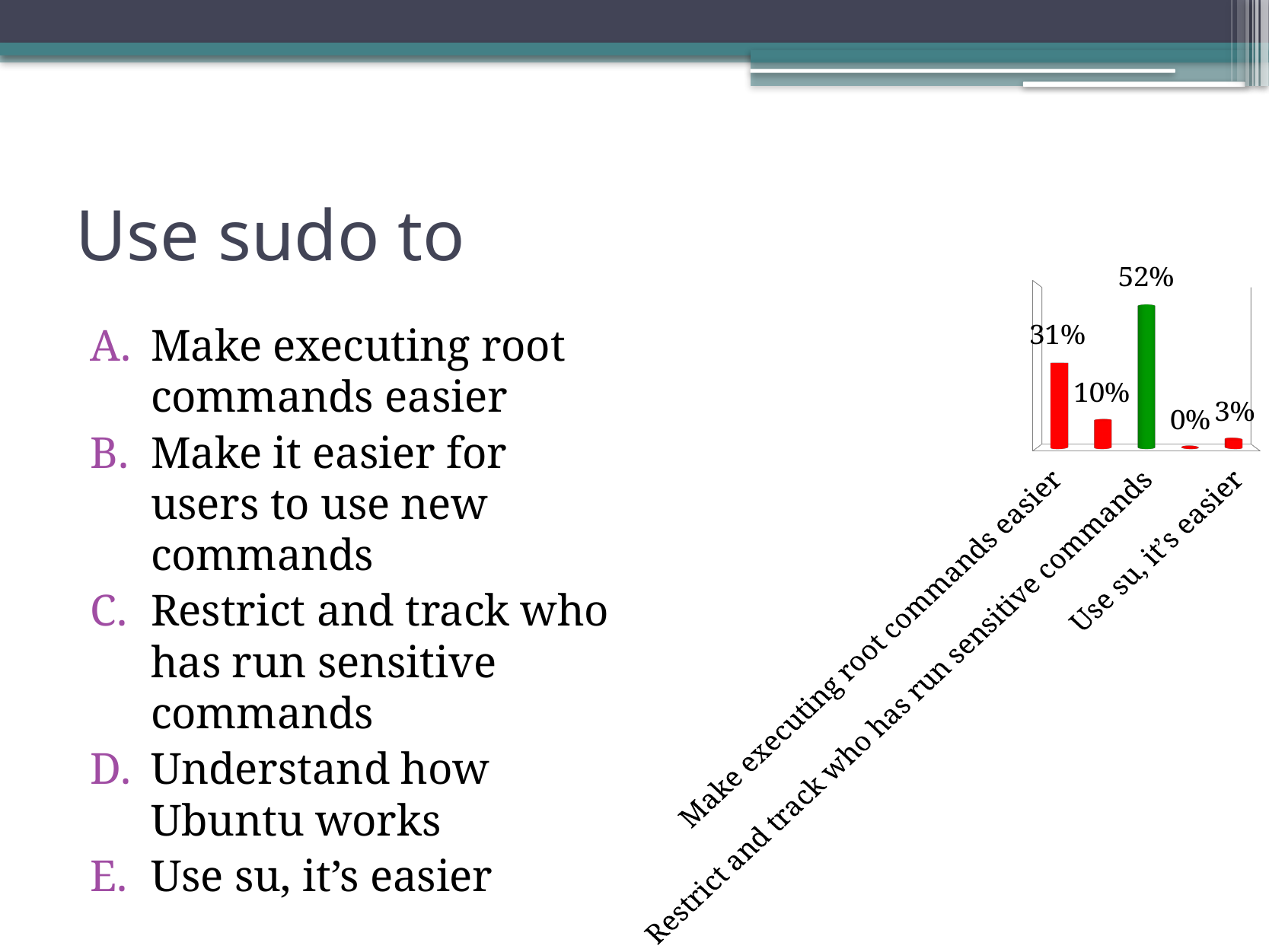
What is the difference between the values for "Restrict and track who has run sensitive commands" and "Make executing root commands easier"? 21% What percentage is shown for "Restrict and track who has run sensitive commands"? 52% What is the difference between the values for "Make executing root commands easier" and "Use su, it's easier"? 28% Which category has the highest value? Restrict and track who has run sensitive commands What colour is the tallest bar in the chart? Green What is the value of the fourth bar from the left? 0% How many bars are in the chart? 5 What percentage is shown for "Make executing root commands easier"? 31% What type of chart is shown on the slide? Bar chart What percentage is shown for "Use su, it's easier"? 3% Which is larger, the value for "Make executing root commands easier" or the value for "Use su, it's easier"? Make executing root commands easier What is the value of the second bar from the left? 10%